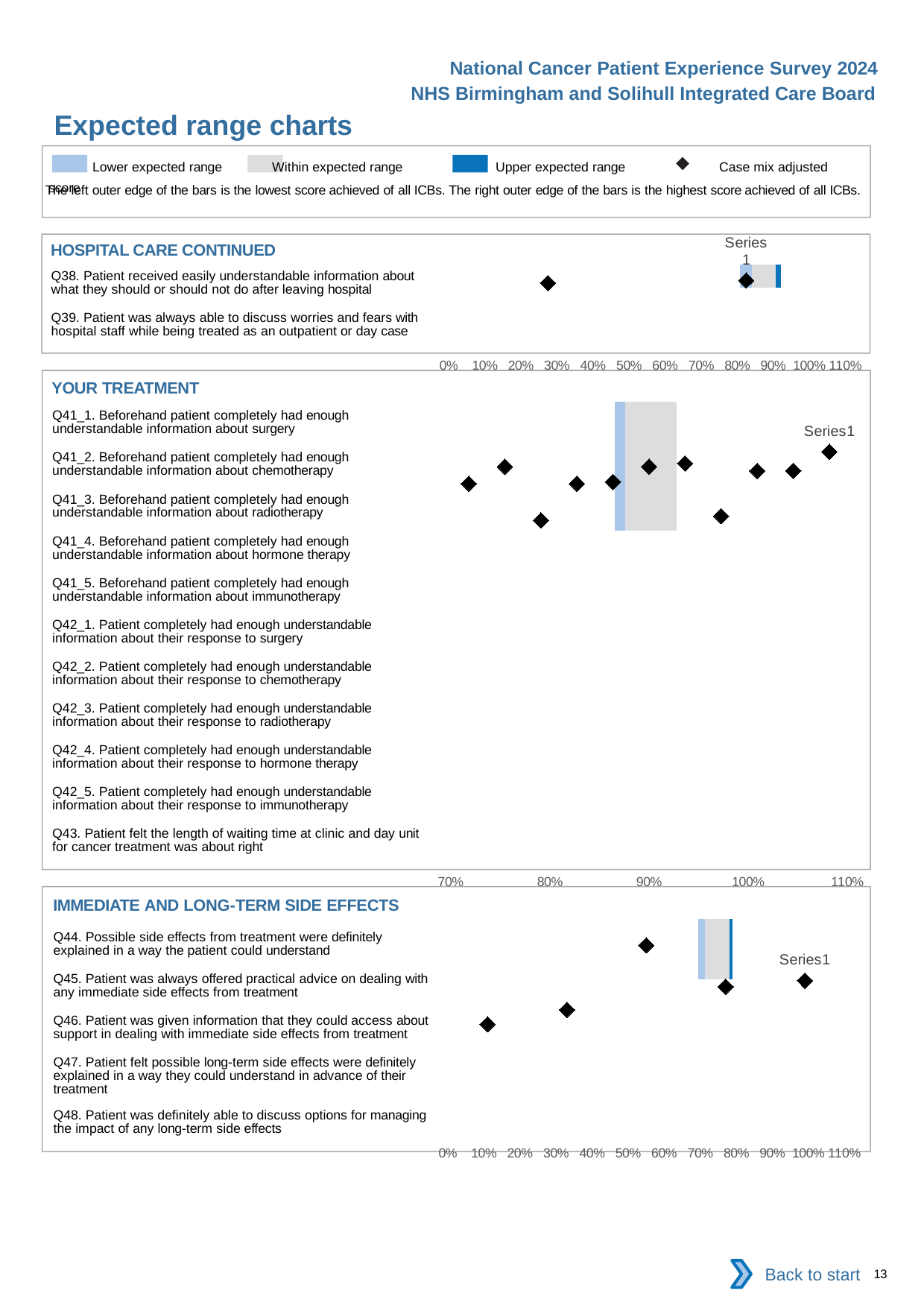
In the legend at the top of the slide, what does the diamond marker represent? Case mix adjusted score What is the highest axis tick shown on the 'HOSPITAL CARE CONTINUED' chart? 110% How many question items are listed in the 'HOSPITAL CARE CONTINUED' chart? 2 How many question items are listed in the 'YOUR TREATMENT' chart? 11 What series name is shown next to the markers in the 'IMMEDIATE AND LONG-TERM SIDE EFFECTS' chart? Series1 What is the lowest axis tick shown on the 'YOUR TREATMENT' chart? 70% How many question items are listed in the 'IMMEDIATE AND LONG-TERM SIDE EFFECTS' chart? 5